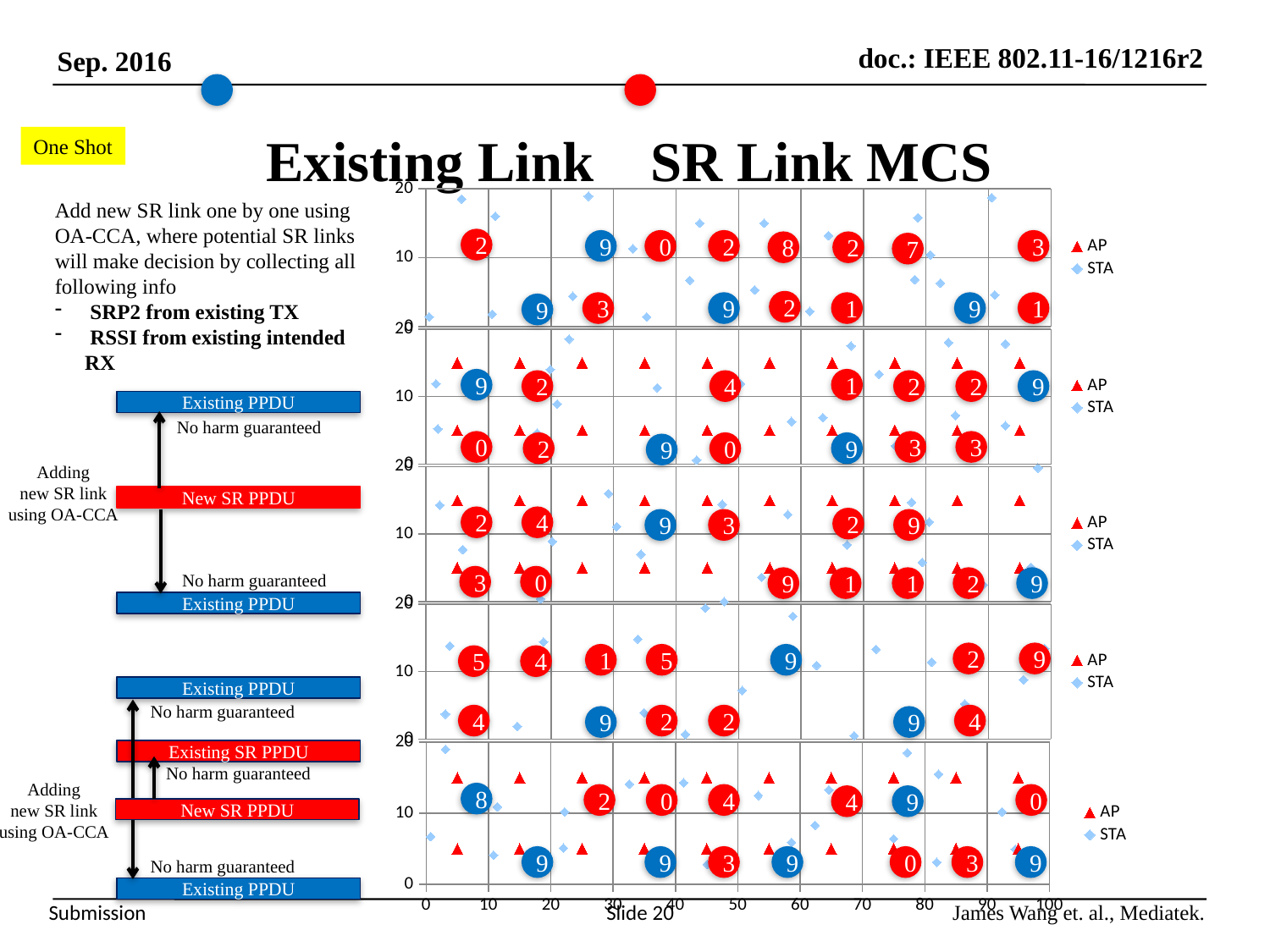
What are the two series named in the legend of each chart? AP and STA How many series does the legend of the bottom chart list? 2 In the bottom chart, which marker shape and colour represents the AP series? red triangle What is the highest value shown on the x axis of the bottom chart? 100 What is the highest value shown on the y axis of the bottom chart? 20 How many separate chart panels are stacked on the right side of the slide? 5 What kind of chart is used in the panels on the right side of the slide? scatter chart How many series does the legend of the top chart list? 2